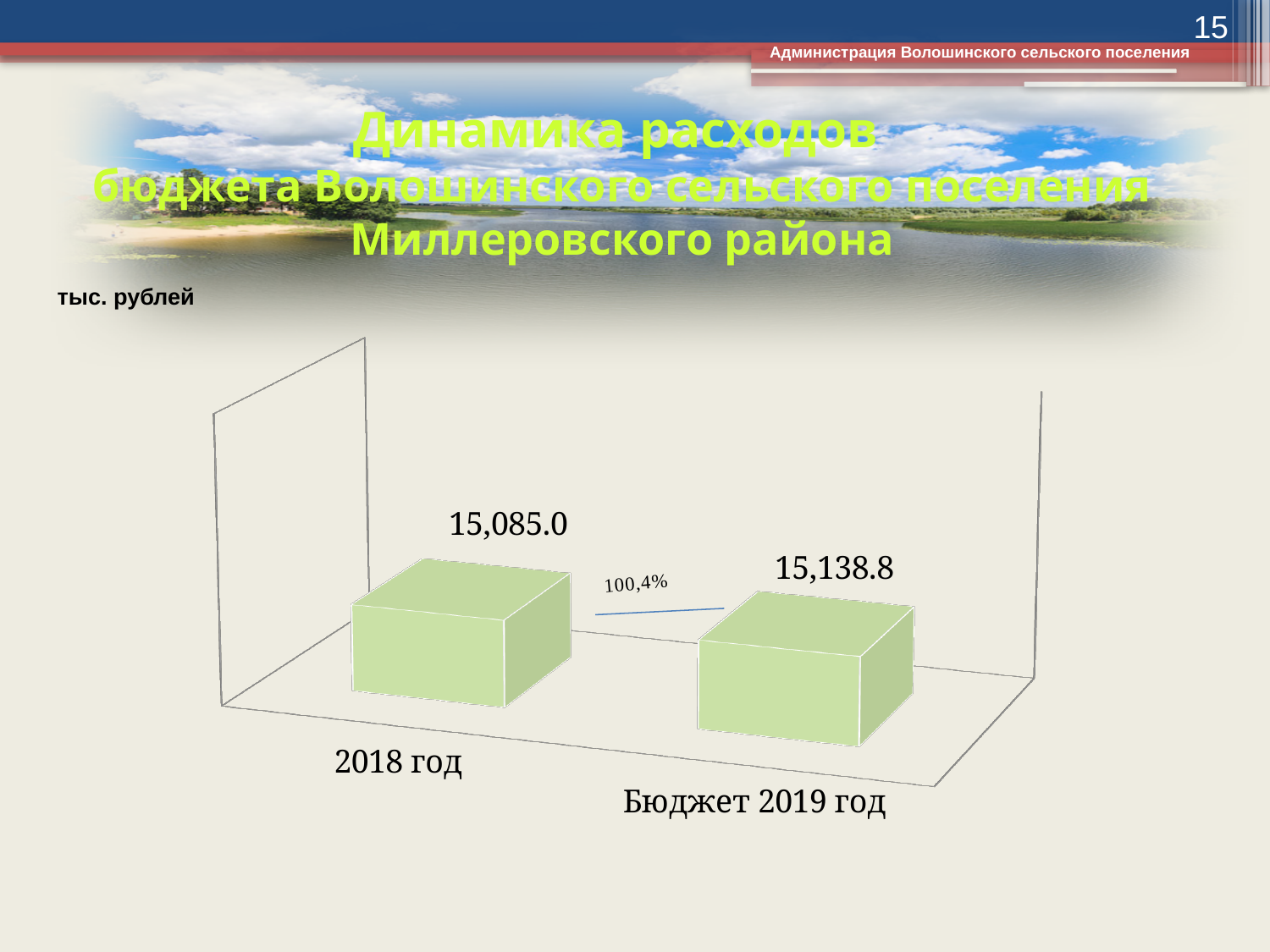
What is the value shown for 2018 год? 15,085.0 Which category has the higher value, 2018 год or Бюджет 2019 год? Бюджет 2019 год Do the values rise or fall from 2018 год to Бюджет 2019 год? rise What is the difference between the value for Бюджет 2019 год and the value for 2018 год? 53.8 Which category has the lowest value on the chart? 2018 год What percentage is written on the connector between the two bars? 100,4% What is the value shown for Бюджет 2019 год? 15,138.8 How many categories are plotted on the chart? 2 What unit of measurement is indicated for the chart values? тыс. рублей Which category has the highest value on the chart? Бюджет 2019 год What kind of chart is shown on the slide? bar chart